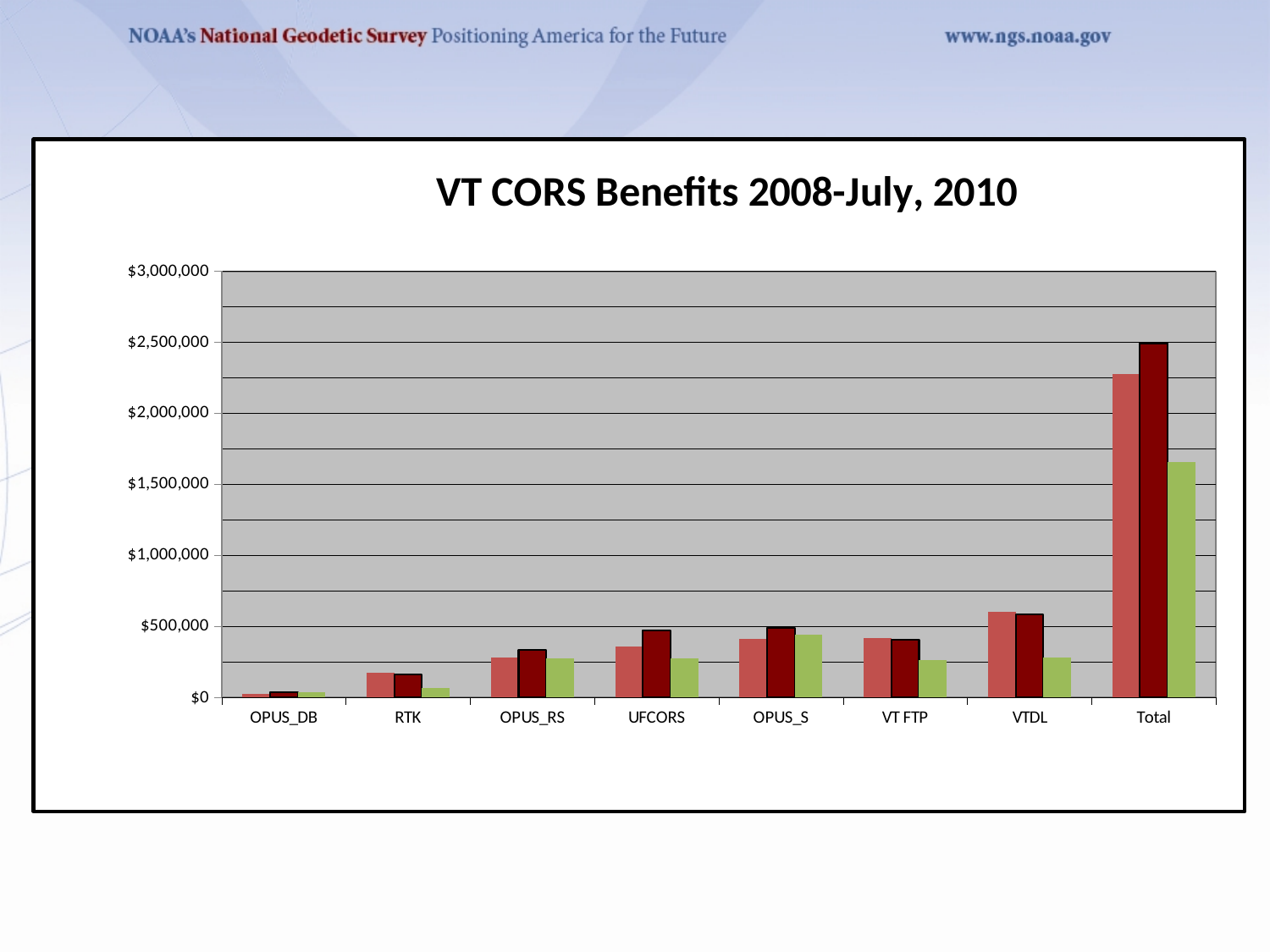
Which category has the larger green bar, OPUS_S or VT FTP? OPUS_S What kind of chart is shown on the slide? bar chart Is the value of the light red bar for VTDL greater or less than $500,000? greater Which category has the tallest bars in the chart? Total How many categories are shown along the x axis of the chart? 8 Which category has the shortest bars in the chart? OPUS_DB Is the value of the dark red bar for Total greater or less than $2,000,000? greater Is the value of the dark red bar for OPUS_DB greater or less than $500,000? less Which category has the larger light red bar, VTDL or RTK? VTDL What is the title of the chart? VT CORS Benefits 2008-July, 2010